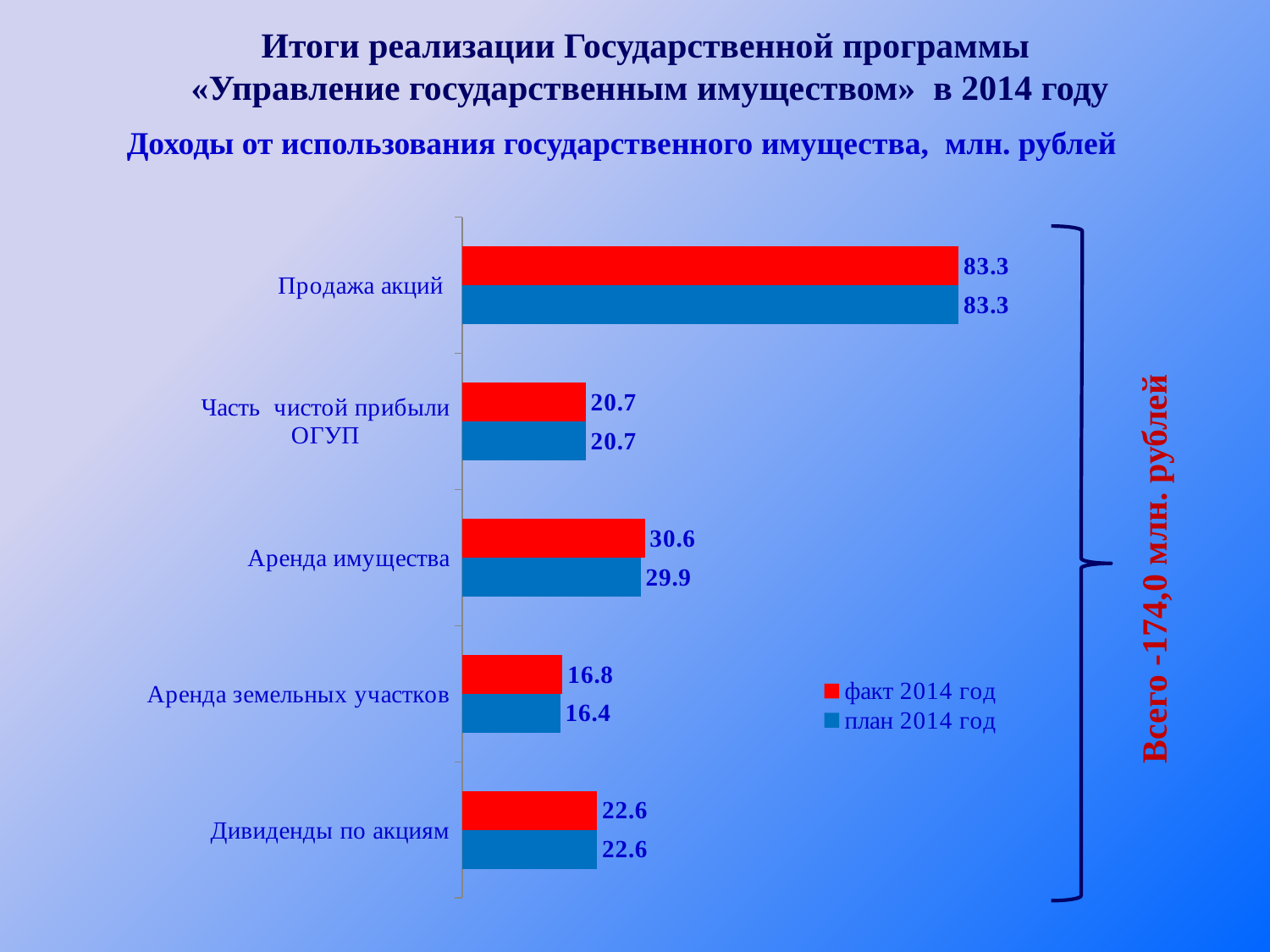
Which category has the lowest 'план 2014 год' value? Аренда земельных участков What is the 'план 2014 год' value for 'Аренда имущества'? 29.9 What is the 'факт 2014 год' value for 'Продажа акций'? 83.3 What is the 'план 2014 год' value for 'Дивиденды по акциям'? 22.6 What is the 'факт 2014 год' value for 'Аренда земельных участков'? 16.8 Which is larger for 'Аренда земельных участков': the 'факт 2014 год' value or the 'план 2014 год' value? факт 2014 год How many series does the legend list? 2 What kind of chart is shown on the slide? Bar chart What is the difference between the 'факт 2014 год' and 'план 2014 год' values for 'Аренда имущества'? 0.7 How many categories are shown on the chart? 5 What total is stated in the red text to the right of the chart? Всего -174,0 млн. рублей Which category has the highest 'факт 2014 год' value? Продажа акций